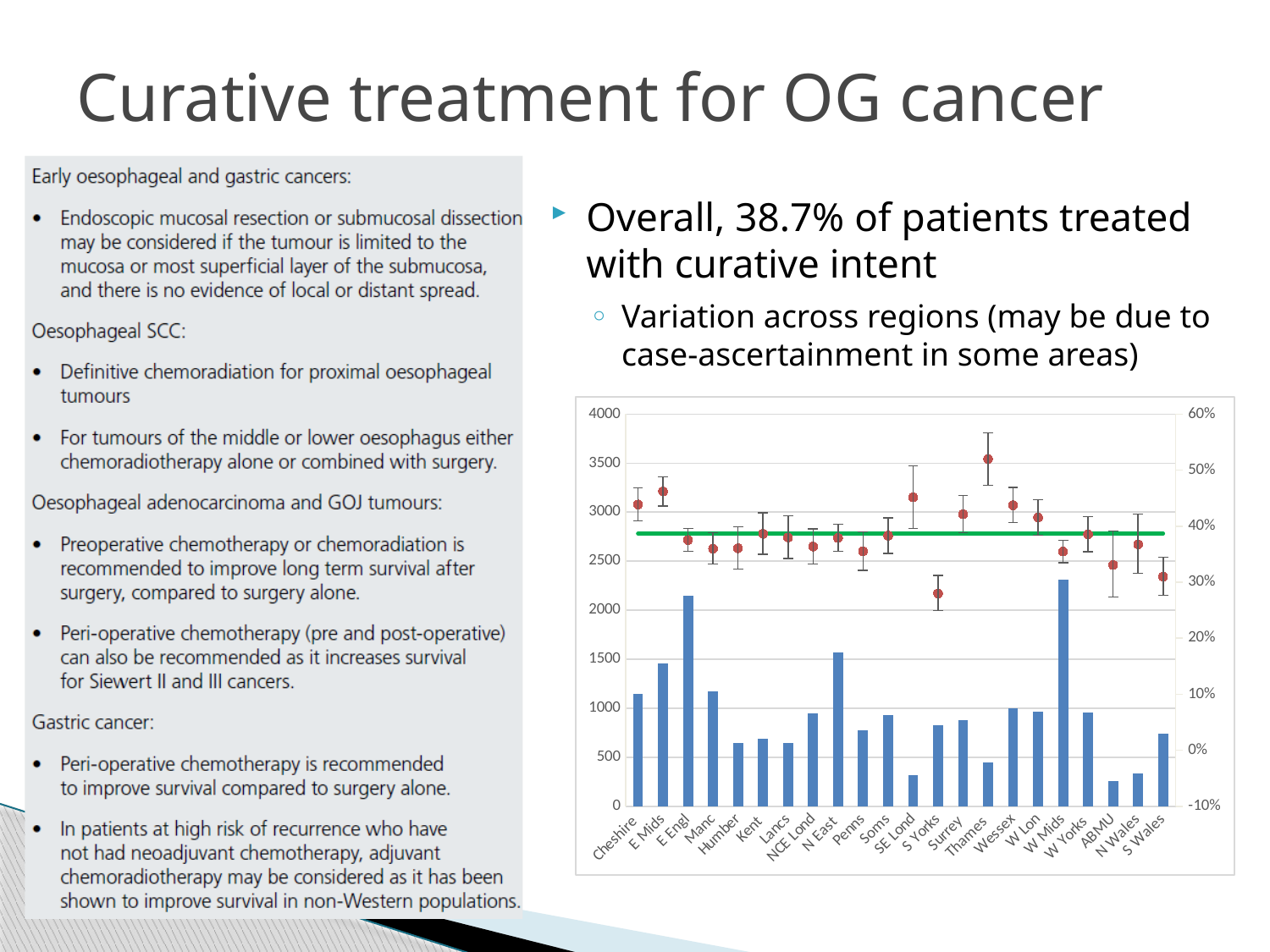
Which has the taller blue bar, E Mids or Cheshire? E Mids Which region has the highest red point (percentage) in the chart? Thames What is the highest value shown on the right-hand percentage axis of the chart? 60% Is the blue bar for E Engl greater or less than 2000? greater Which region has the lowest red point (percentage) in the chart? S Yorks Is the blue bar for SE Lond greater or less than 500? less Which region has the tallest blue bar in the chart? W Mids Is the blue bar for Cheshire greater or less than 1000? greater How many regions are shown along the x axis of the chart? 22 What kind of chart is shown on the slide? combination bar and line chart Which has the taller blue bar, W Mids or E Engl? W Mids Which region has the shortest blue bar in the chart? ABMU